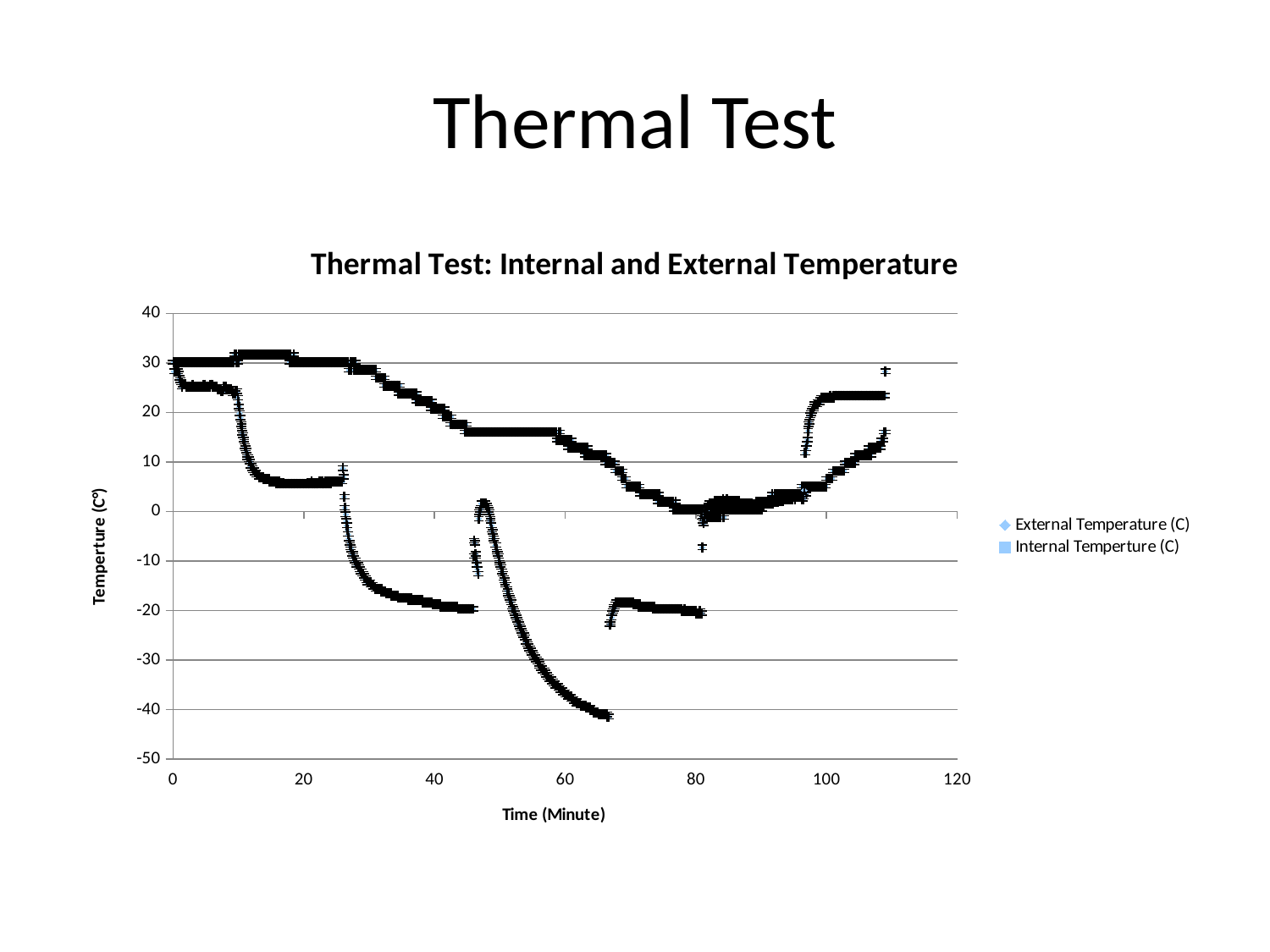
How many series does the legend list? 2 Is the lowest plotted temperature greater or less than -30? less Is the highest plotted temperature greater or less than 20? greater What kind of chart is shown on the slide? scatter chart What is the title of the chart? Thermal Test: Internal and External Temperature Is the lowest plotted temperature greater or less than -50? greater What are the two series named in the legend? External Temperature (C) and Internal Temperture (C)